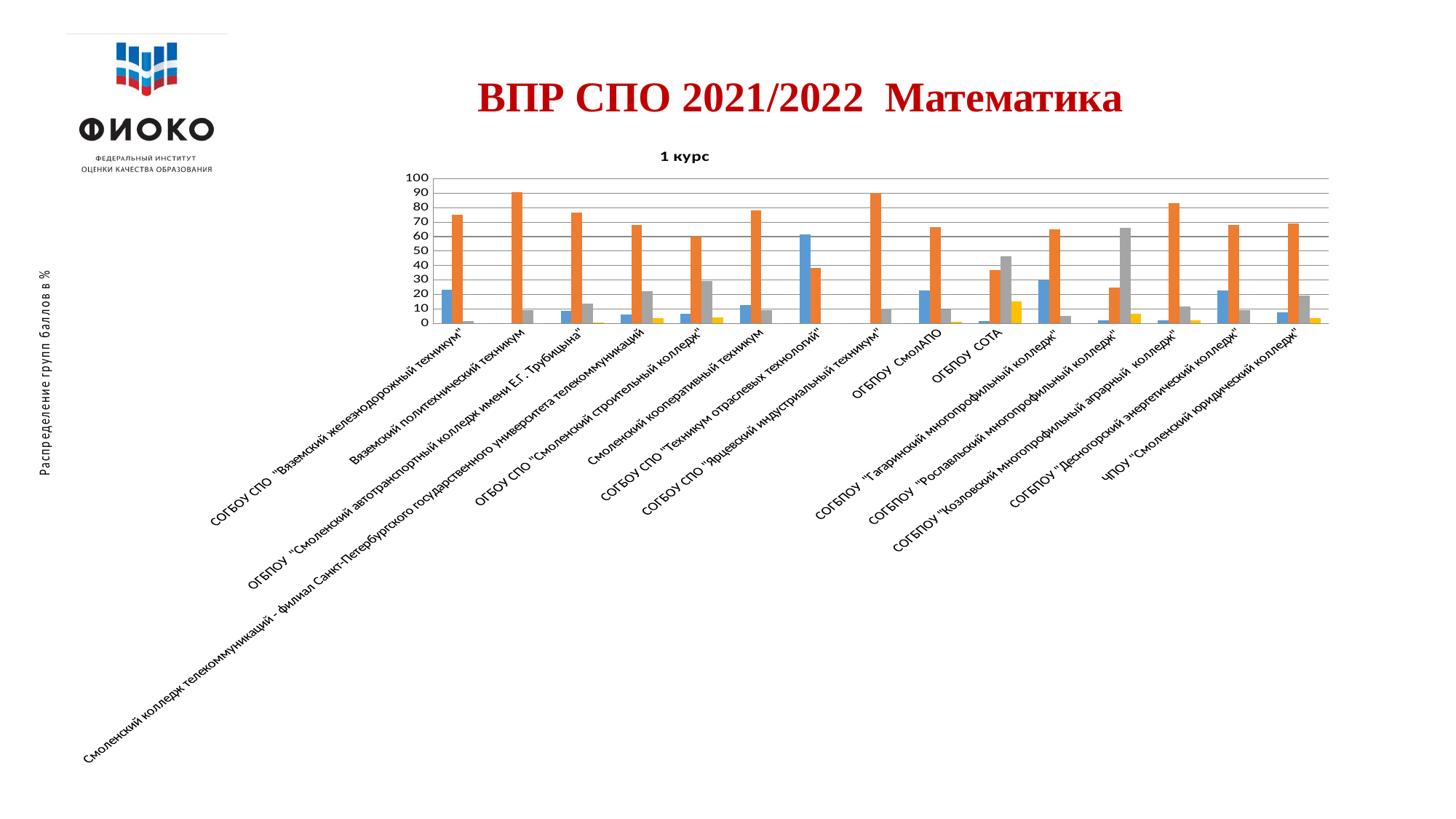
Is the orange bar for СОГБПОУ "Козловский многопрофильный аграрный колледж" greater or less than 80? greater What is the title of the chart? 1 курс Is the orange bar for Вяземский политехнический техникум greater or less than 80? greater Which institution has the tallest blue bar? СОГБОУ СПО "Техникум отраслевых технологий" How many institutions (categories) are shown on the x axis of the chart? 15 Which institution has the shortest orange bar? СОГБПОУ "Рославльский многопрофильный колледж" Which is larger: the orange bar for СОГБОУ СПО "Вяземский железнодорожный техникум" or the orange bar for ОГБОУ СПО "Смоленский строительный колледж"? СОГБОУ СПО "Вяземский железнодорожный техникум" What is the label on the vertical axis of the chart? Распределение групп баллов в % Which institution has the tallest gray bar? СОГБПОУ "Рославльский многопрофильный колледж" What kind of chart is shown on the slide? bar chart Is the orange bar for СОГБПОУ "Рославльский многопрофильный колледж" greater or less than 30? less